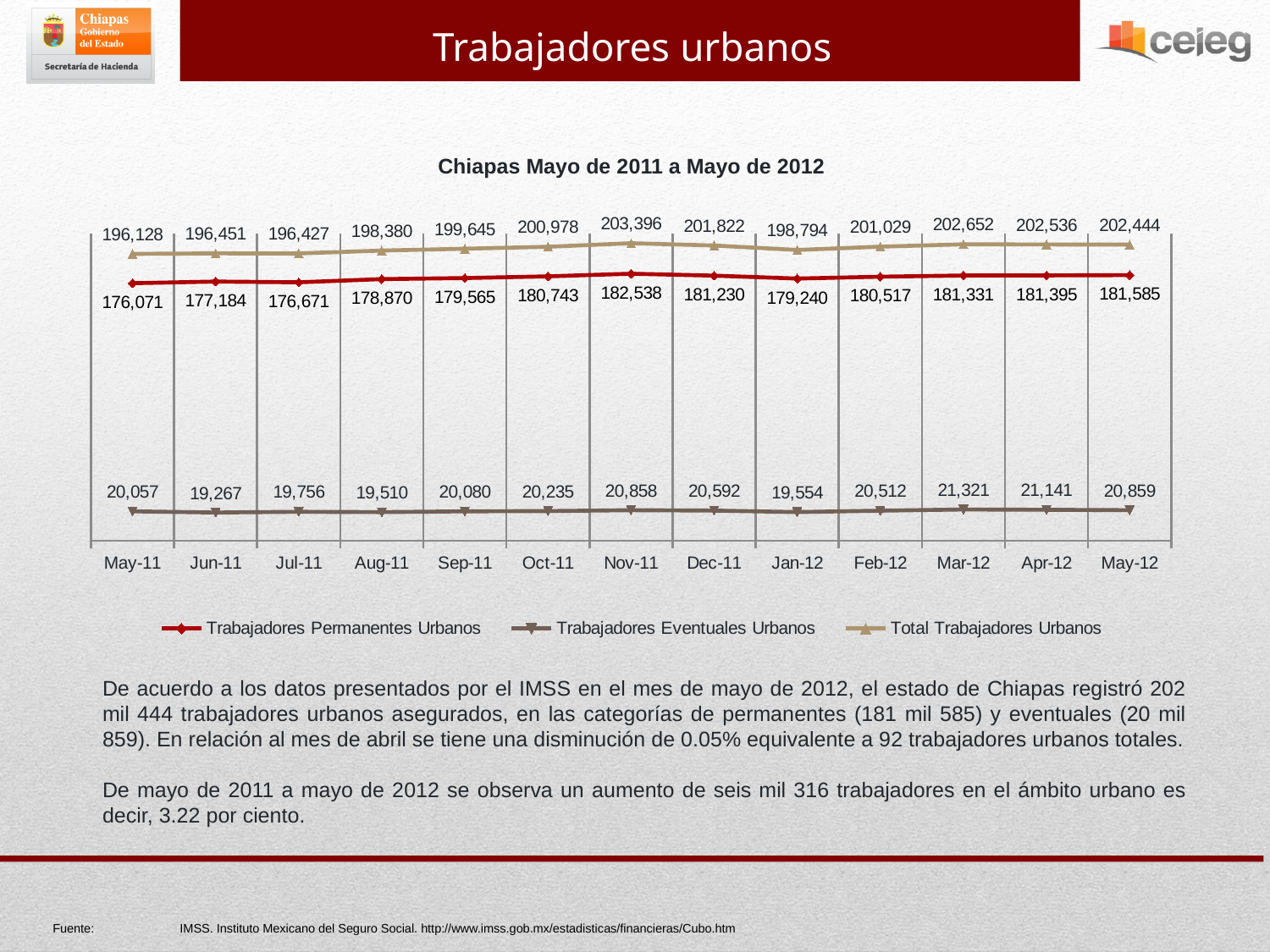
What is the value of Trabajadores Permanentes Urbanos for Nov-11? 182,538 How many months are plotted along the x axis? 13 What is the value of Trabajadores Eventuales Urbanos for Jan-12? 19,554 In which month is Trabajadores Permanentes Urbanos lowest? May-11 How many series does the legend list? 3 What is the value of Total Trabajadores Urbanos for May-12? 202,444 What is the difference between Total Trabajadores Urbanos in May-12 and May-11? 6,316 What is the title of the chart? Chiapas Mayo de 2011 a Mayo de 2012 What type of chart is shown on the slide? Line chart In which month is Total Trabajadores Urbanos highest? Nov-11 Which is larger for Trabajadores Eventuales Urbanos: Mar-12 or Apr-12? Mar-12 In which month is Trabajadores Eventuales Urbanos lowest? Jun-11